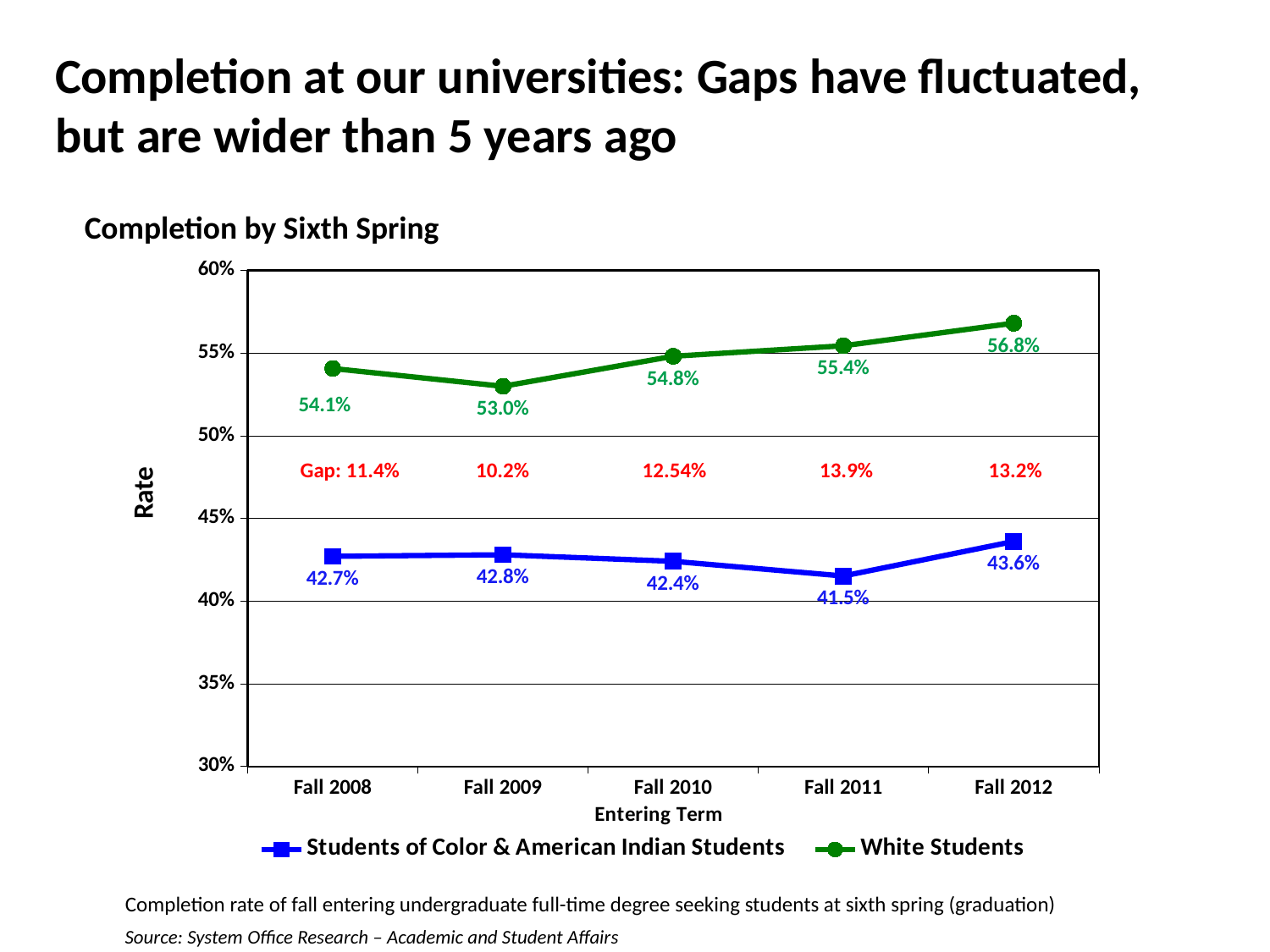
What is the difference between the White Students rate and the Students of Color & American Indian Students rate in Fall 2012? 13.2% What is the completion rate for Students of Color & American Indian Students in Fall 2011? 41.5% What is the title of the chart? Completion by Sixth Spring Does the completion rate for White Students rise or fall from Fall 2009 to Fall 2012? rise Which series has the higher completion rate in Fall 2009? White Students How many series does the legend list? 2 What kind of chart is shown on the slide? line chart How many entering terms are shown on the x axis? 5 Is the completion rate for Students of Color & American Indian Students in Fall 2012 greater or less than 45%? less In which entering term is the completion rate for Students of Color & American Indian Students lowest? Fall 2011 In which entering term is the completion rate for White Students highest? Fall 2012 What is the completion rate for White Students in Fall 2010? 54.8%